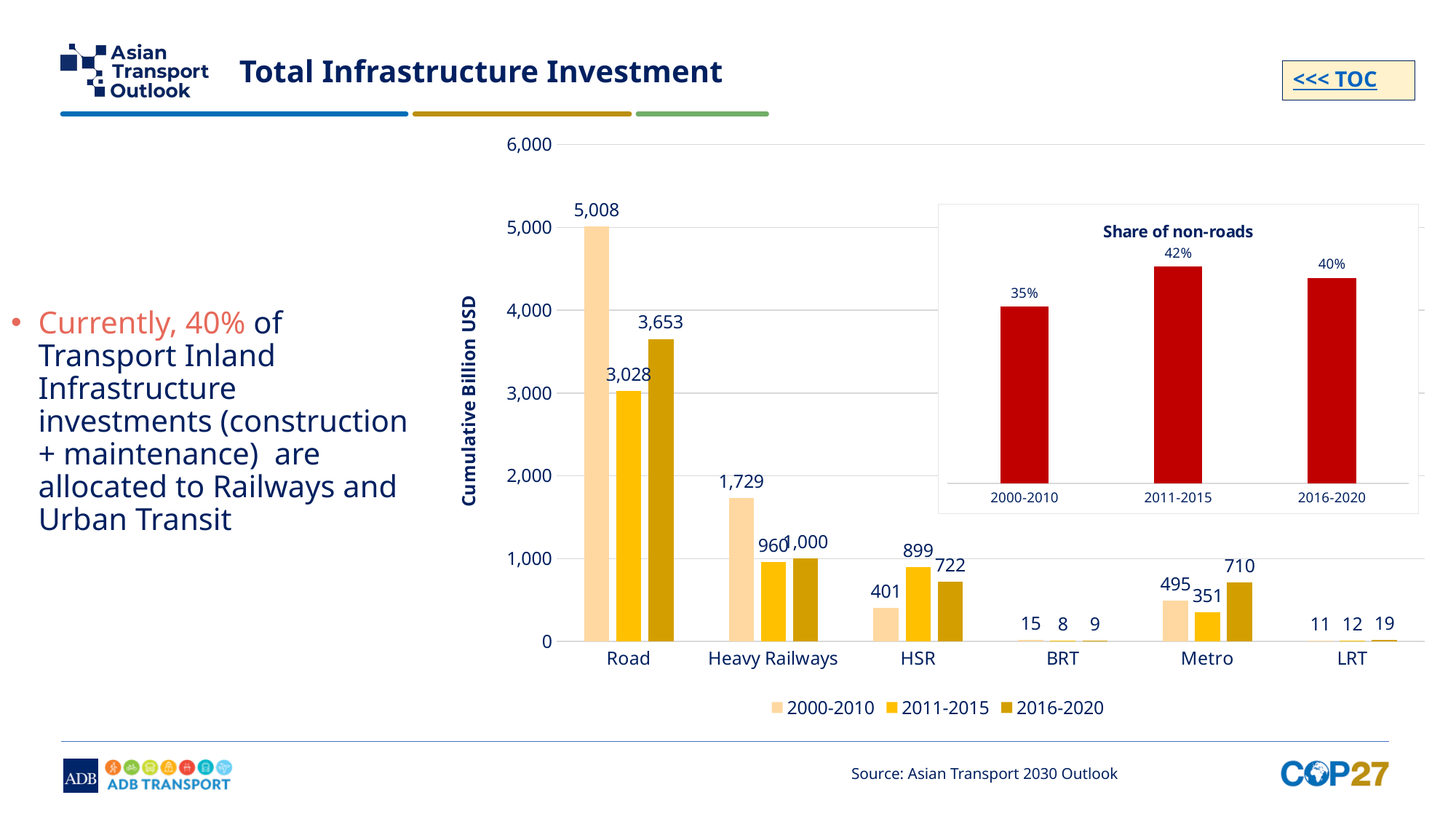
In the main bar chart, which is larger for Heavy Railways: the 2011-2015 value or the 2016-2020 value? 2016-2020 In the 'Share of non-roads' chart, what is the value for 2011-2015? 42% How many series does the legend of the main bar chart list? 3 In the main bar chart, what is the value for Road in the 2000-2010 series? 5,008 In the main bar chart, what is the difference between the Road values for 2000-2010 and 2011-2015? 1,980 In the main bar chart, what is the value for Metro in the 2016-2020 series? 710 In the main bar chart, which category has the highest value in the 2016-2020 series? Road In the 'Share of non-roads' chart, which period has the lowest share? 2000-2010 What is the y-axis label of the main bar chart? Cumulative Billion USD In the main bar chart, what is the value for HSR in the 2011-2015 series? 899 In the main bar chart, which category has the lowest value in the 2011-2015 series? BRT How many categories are shown on the x axis of the main bar chart? 6